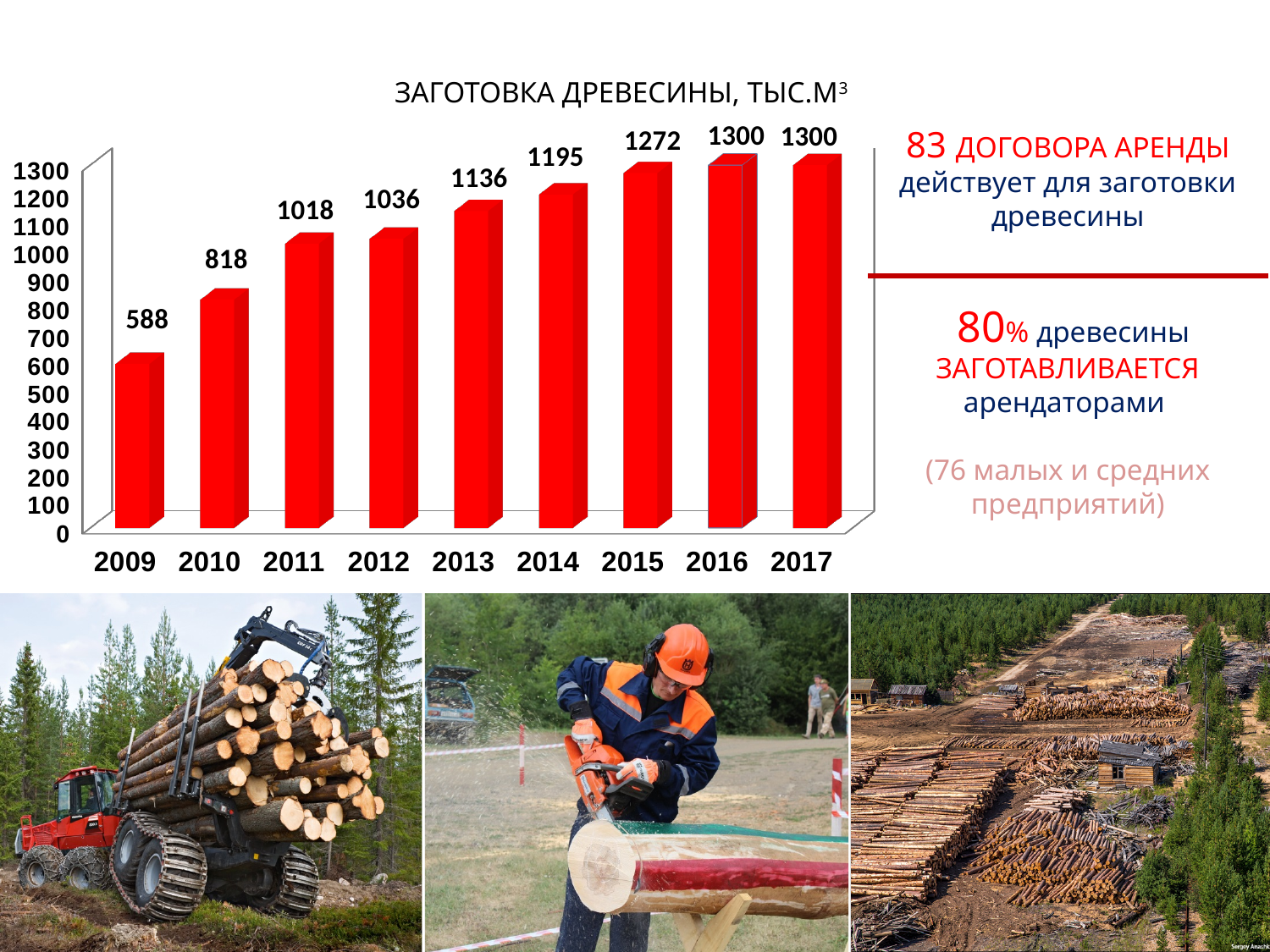
Which year has the lowest value? 2009 What kind of chart is shown? bar chart What is the difference between the values for 2010 and 2009? 230 How many years are shown on the x axis? 9 What is the value for 2015? 1272 Is the value for 2014 greater or less than 1100? greater Which is larger, the value for 2011 or the value for 2012? 2012 What is the difference between the values for 2017 and 2014? 105 Do the values rise or fall from 2009 to 2017? rise What is the title of the chart? ЗАГОТОВКА ДРЕВЕСИНЫ, ТЫС.М³ What is the value for 2013? 1136 What is the value for 2009? 588